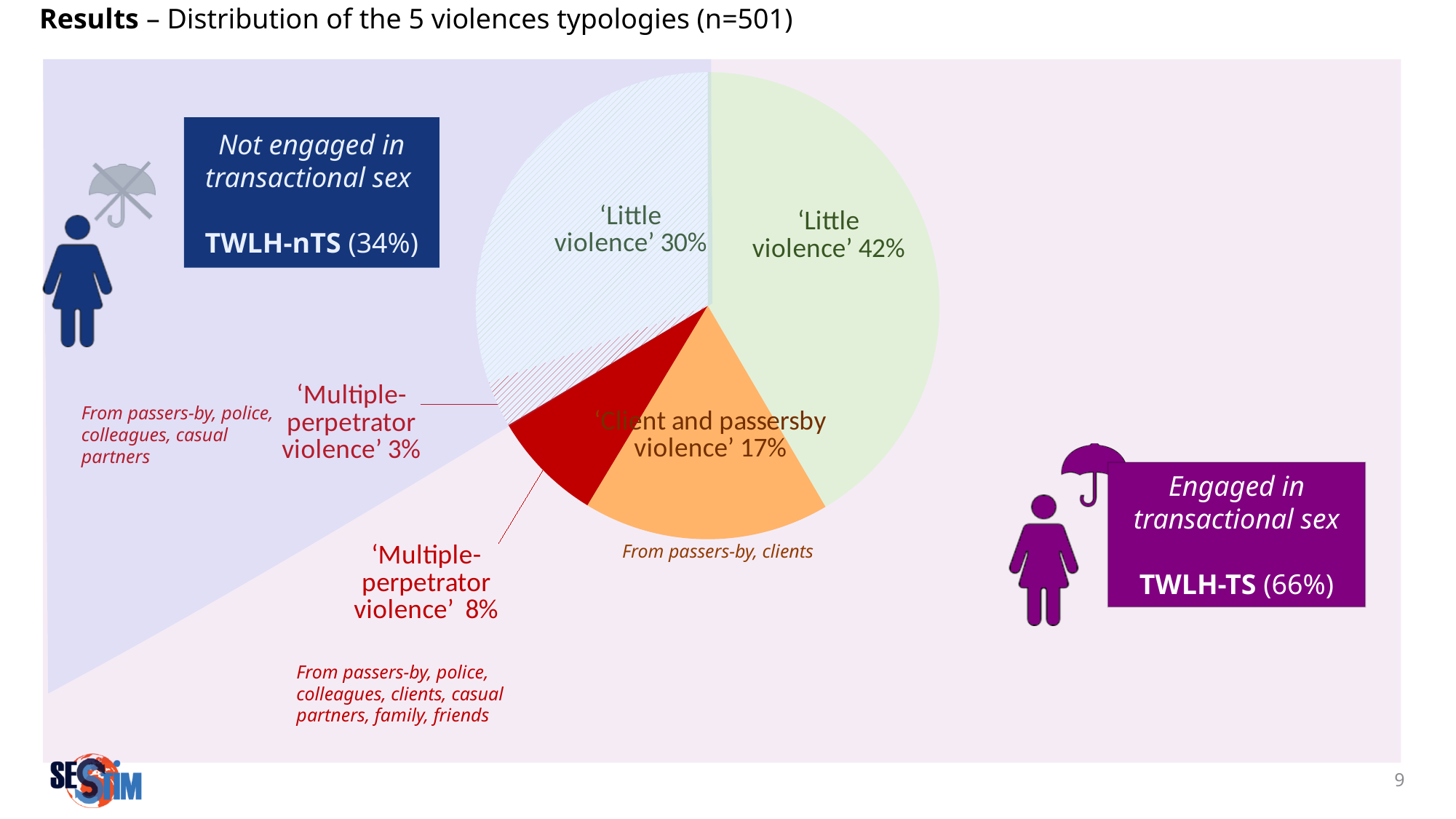
Which slice of the pie chart is the largest? 'Little violence' 42% (TWLH-TS) What kind of chart is shown on the slide? pie chart What share of the pie is the 'Multiple-perpetrator violence' slice for women not engaged in transactional sex (TWLH-nTS)? 3% What share of the pie is the 'Little violence' slice for women not engaged in transactional sex (TWLH-nTS)? 30% What share of the pie is the 'Client and passersby violence' slice? 17% Which slice of the pie chart is the smallest? 'Multiple-perpetrator violence' 3% (TWLH-nTS) Which is larger: the 'Client and passersby violence' slice or the 'Multiple-perpetrator violence' 8% slice? 'Client and passersby violence' What share of the pie is the 'Multiple-perpetrator violence' slice for women engaged in transactional sex (TWLH-TS)? 8% According to the slide, what percentage of the sample is engaged in transactional sex (TWLH-TS)? 66% What share of the pie is the 'Little violence' slice for women engaged in transactional sex (TWLH-TS)? 42% How many slices does the pie chart have? 5 What is the difference in percentage points between the two 'Little violence' slices (42% and 30%)? 12 percentage points